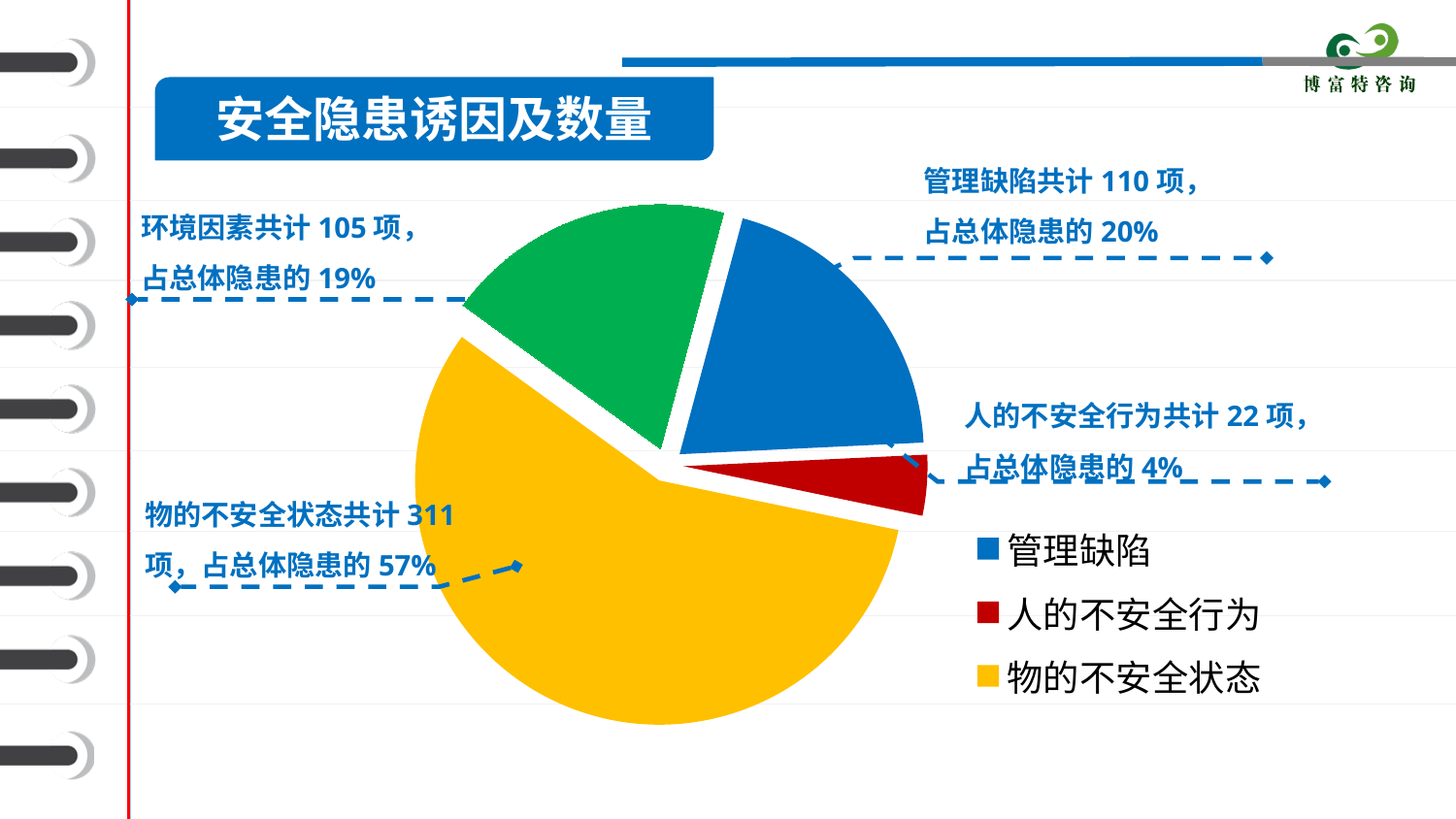
Which category has the smallest slice of the pie? 人的不安全行为 What colour is the slice for 人的不安全行为? red What share of the total hazards does 人的不安全行为 account for? 4% How many entries does the legend list? 3 Which category has the largest slice of the pie? 物的不安全状态 What is the difference between the number of items for 物的不安全状态 and 管理缺陷? 201 How many items does the annotation give for 环境因素? 105 项 What share of the total hazards does 物的不安全状态 account for? 57% How many items does the annotation give for 管理缺陷? 110 项 What kind of chart is shown on the slide? pie chart Which is larger, the number of items for 管理缺陷 or for 环境因素? 管理缺陷 What is the title of the chart on the slide? 安全隐患诱因及数量